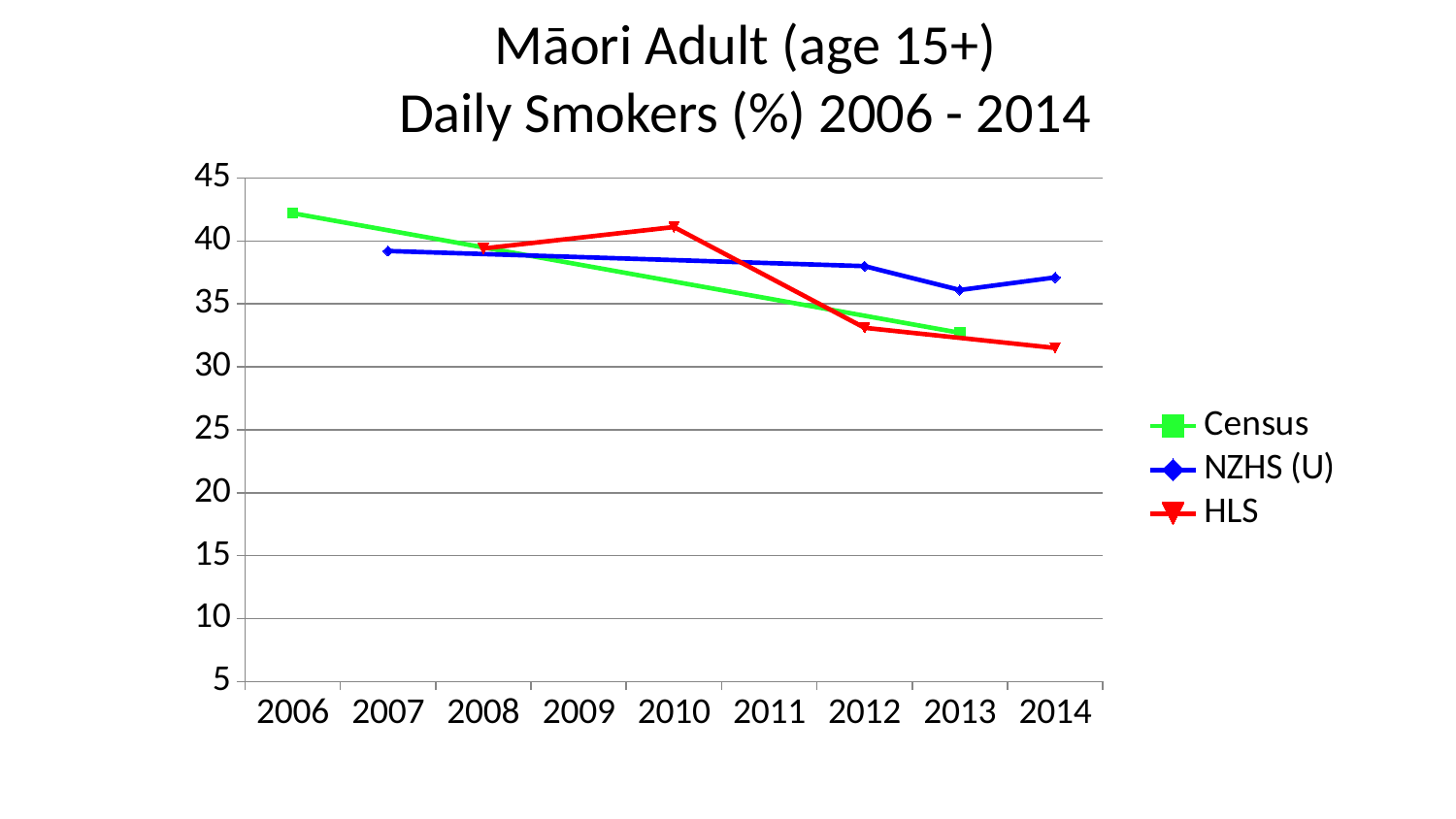
Is the Census value for 2006 greater or less than 40? greater In which year does the HLS series reach its highest value? 2010 Which series is drawn in red? HLS How many years are shown on the x axis? 9 Is the HLS value for 2010 greater or less than 40? greater Is the NZHS (U) value for 2013 greater or less than 35? greater In 2012, which series has the higher value, NZHS (U) or HLS? NZHS (U) What kind of chart is shown on the slide? line chart How many series does the legend list? 3 What is the title of the chart? Māori Adult (age 15+) Daily Smokers (%) 2006 - 2014 Does the Census line rise or fall from 2006 to 2013? fall